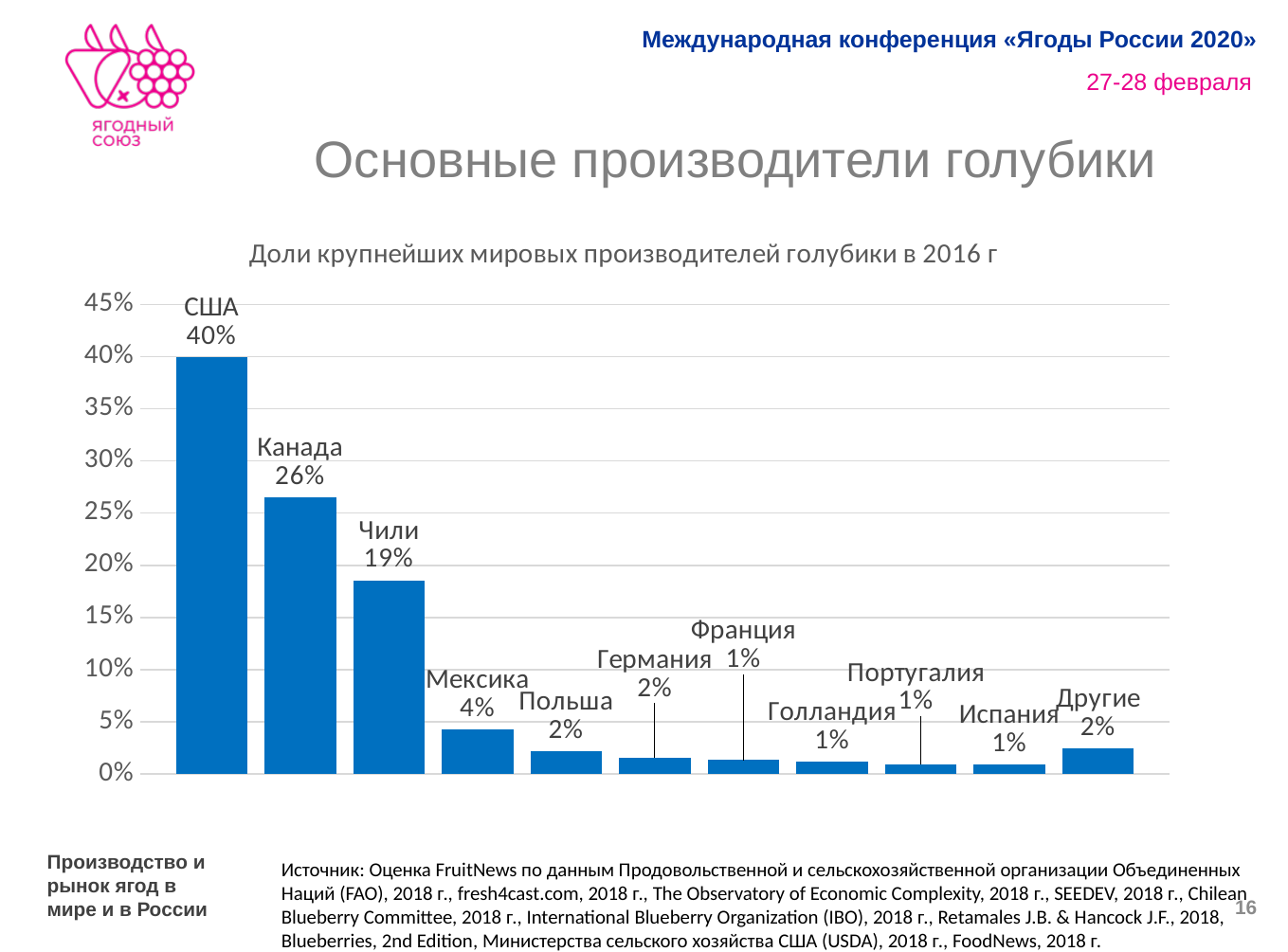
What is the value for Другие? 2% What is the value for США? 40% What is the title of the chart? Доли крупнейших мировых производителей голубики в 2016 г Which is larger, the value for Канада or the value for Чили? Канада Which category has the highest value? США What is the value for Канада? 26% What kind of chart is shown on the slide? bar chart What is the value for Мексика? 4% Is the value for США greater or less than 35%? greater What is the value for Чили? 19% How many categories are shown on the chart? 11 What is the difference between the values for США and Канада? 14%